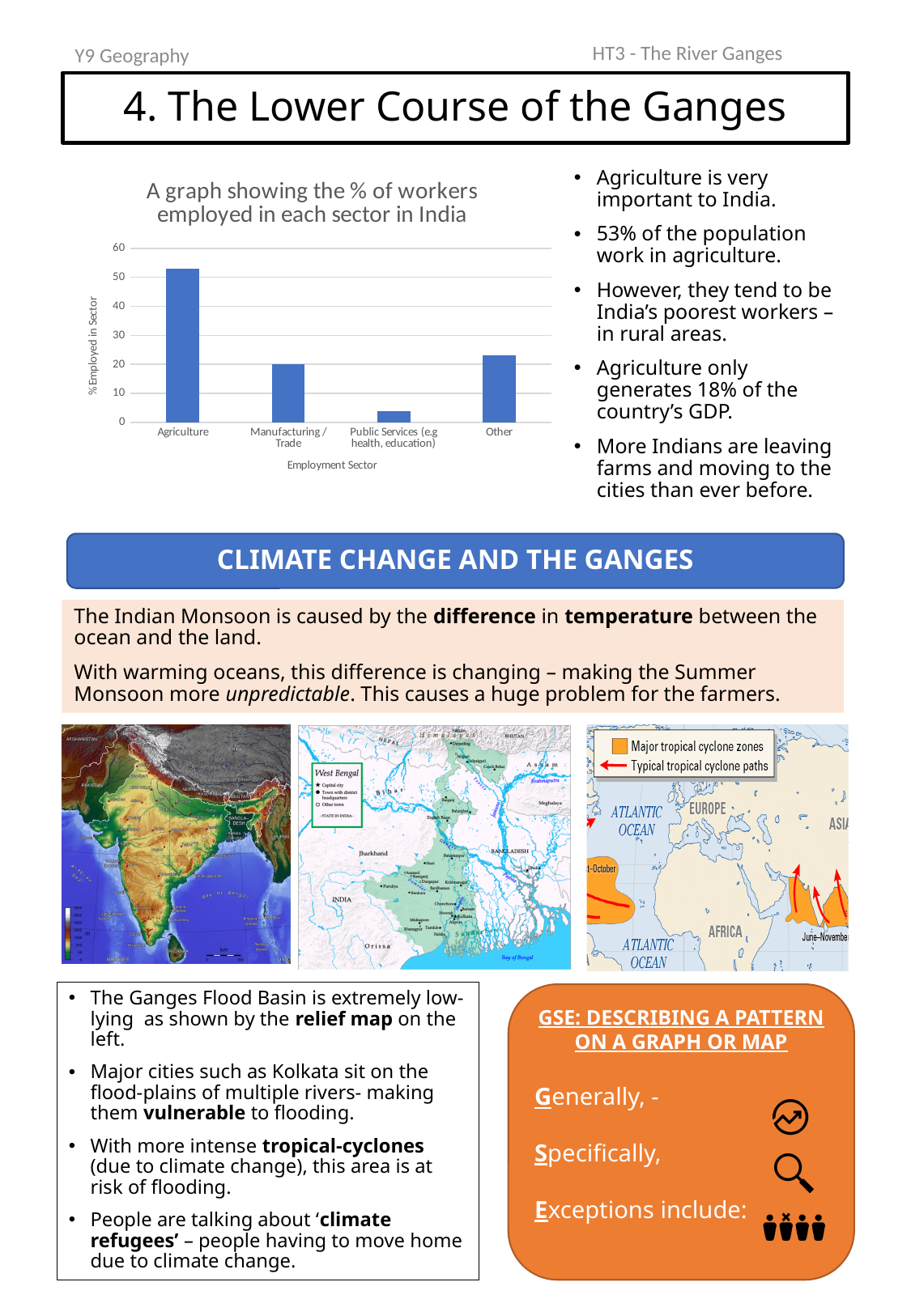
Which employment sector has the highest % of workers employed? Agriculture Is the value for Public Services (e.g health, education) greater or less than 10? less Which employment sector has the lowest % of workers employed? Public Services (e.g health, education) Which has a higher % employed: Agriculture or Other? Agriculture Which has a higher % employed: Manufacturing / Trade or Public Services (e.g health, education)? Manufacturing / Trade What is the label on the vertical axis of the chart? % Employed in Sector Is the value for Agriculture greater or less than 50? greater What kind of chart is shown on the slide? bar chart Is the value for Other greater or less than 30? less How many employment sectors are shown on the chart? 4 What is the title of the chart? A graph showing the % of workers employed in each sector in India